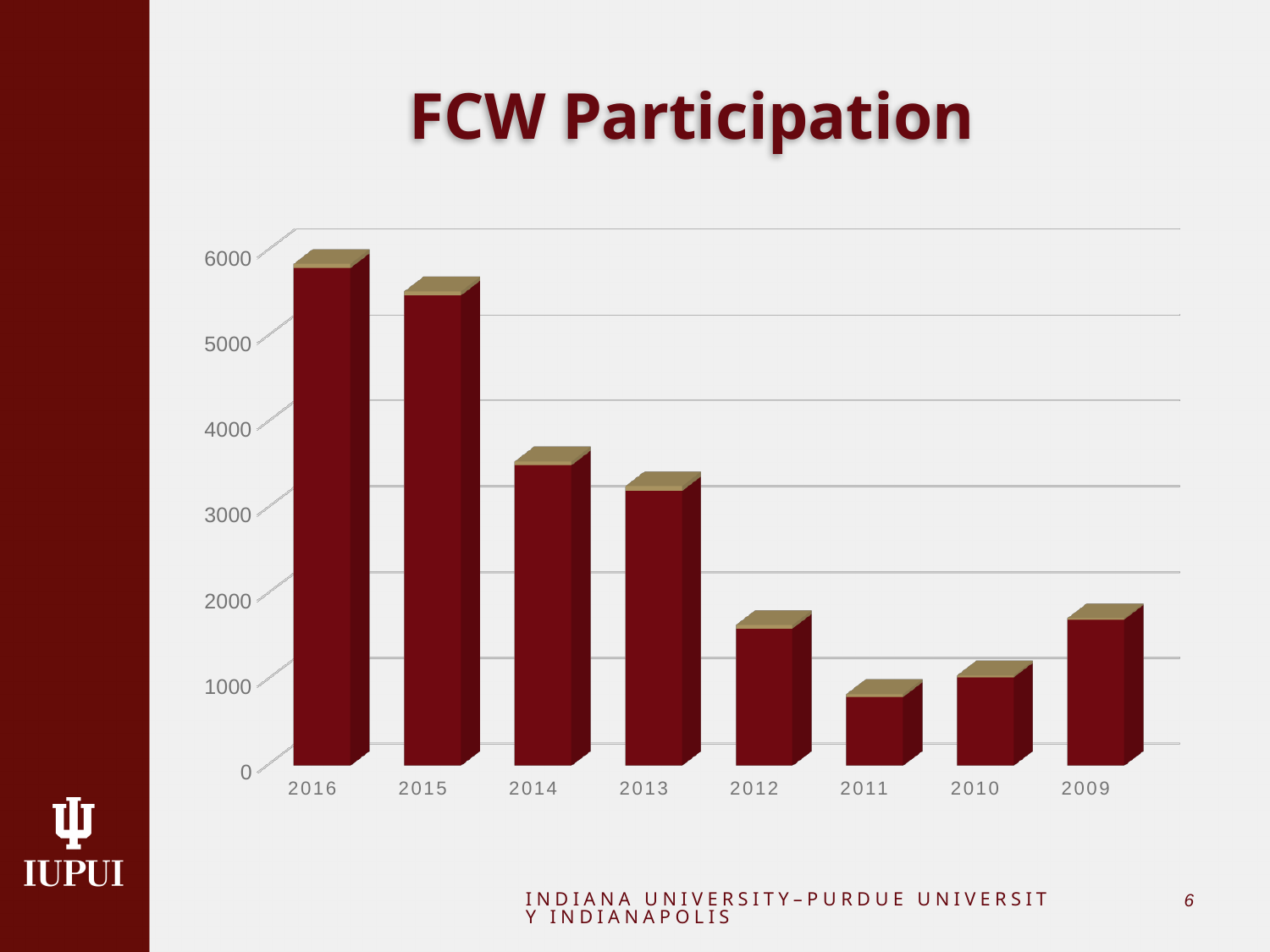
Is the value for 2016 greater or less than 5000? greater What is the title of the chart? FCW Participation Do the bars generally rise or fall from left to right along the x axis? fall Is the value for 2015 greater or less than 5000? greater Is the value for 2011 greater or less than 1000? less Which year has the highest FCW participation? 2016 Which year has the lowest FCW participation? 2011 Which year has the larger value, 2016 or 2015? 2016 How many years are shown on the x axis of the chart? 8 What kind of chart is shown on the slide? bar chart